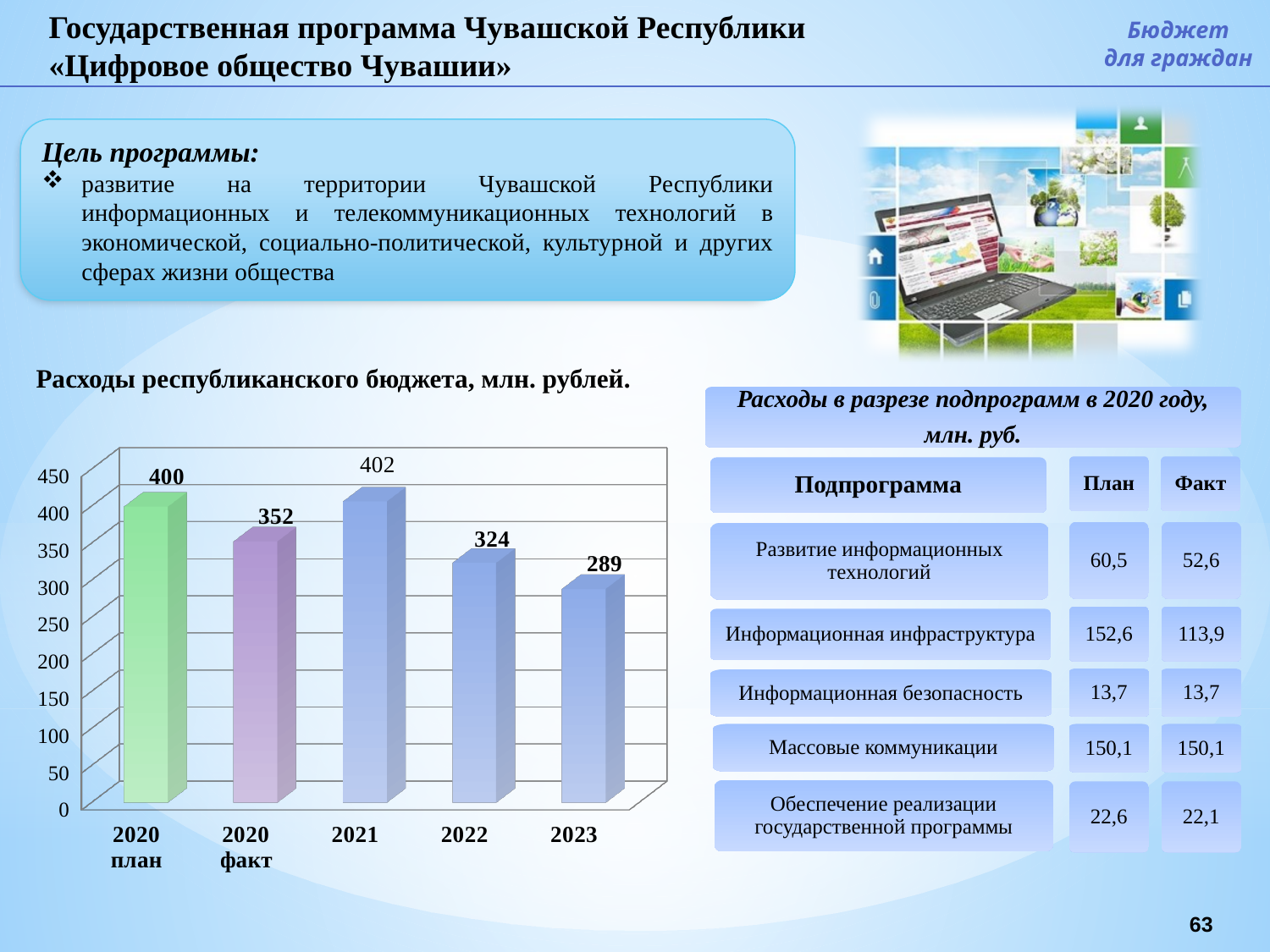
Which category has the highest value in the chart? 2021 What kind of chart is shown on the slide? bar chart What is the value for 2023 in the chart? 289 Do the values rise or fall from 2021 to 2023? fall What is the value for 2020 факт in the chart? 352 Which category has the lowest value in the chart? 2023 Which is larger, the value for 2021 or the value for 2022? 2021 How many categories are shown on the x axis of the chart? 5 Is the value for 2022 greater or less than 350? less What is the difference between the values for 2020 план and 2020 факт? 48 What is the difference between the values for 2022 and 2023? 35 What is the value for 2020 план in the chart "Расходы республиканского бюджета, млн. рублей"? 400